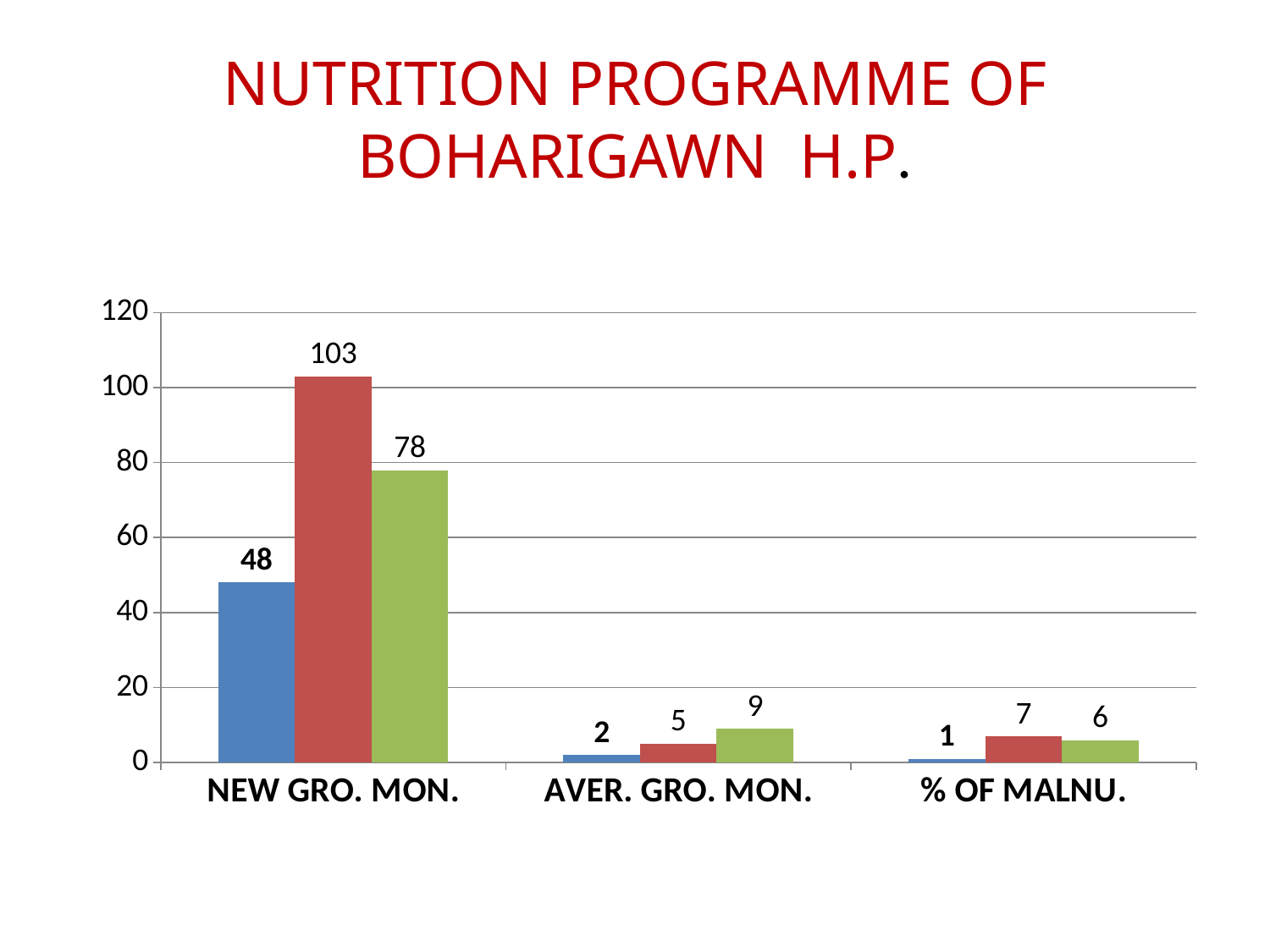
Which is larger for % OF MALNU., the red bar or the green bar? the red bar How many categories are shown on the x axis? 3 What is the value of the blue bar for NEW GRO. MON.? 48 What is the value of the red bar for % OF MALNU.? 7 What is the value of the red bar for NEW GRO. MON.? 103 Is the value of the green bar for NEW GRO. MON. greater or less than 60? greater Which category has the highest red bar? NEW GRO. MON. What is the value of the green bar for AVER. GRO. MON.? 9 What kind of chart is shown on the slide? bar chart What is the title of the slide? NUTRITION PROGRAMME OF BOHARIGAWN H.P. What is the difference between the red and green bars for NEW GRO. MON.? 25 Which category has the lowest blue bar? % OF MALNU.